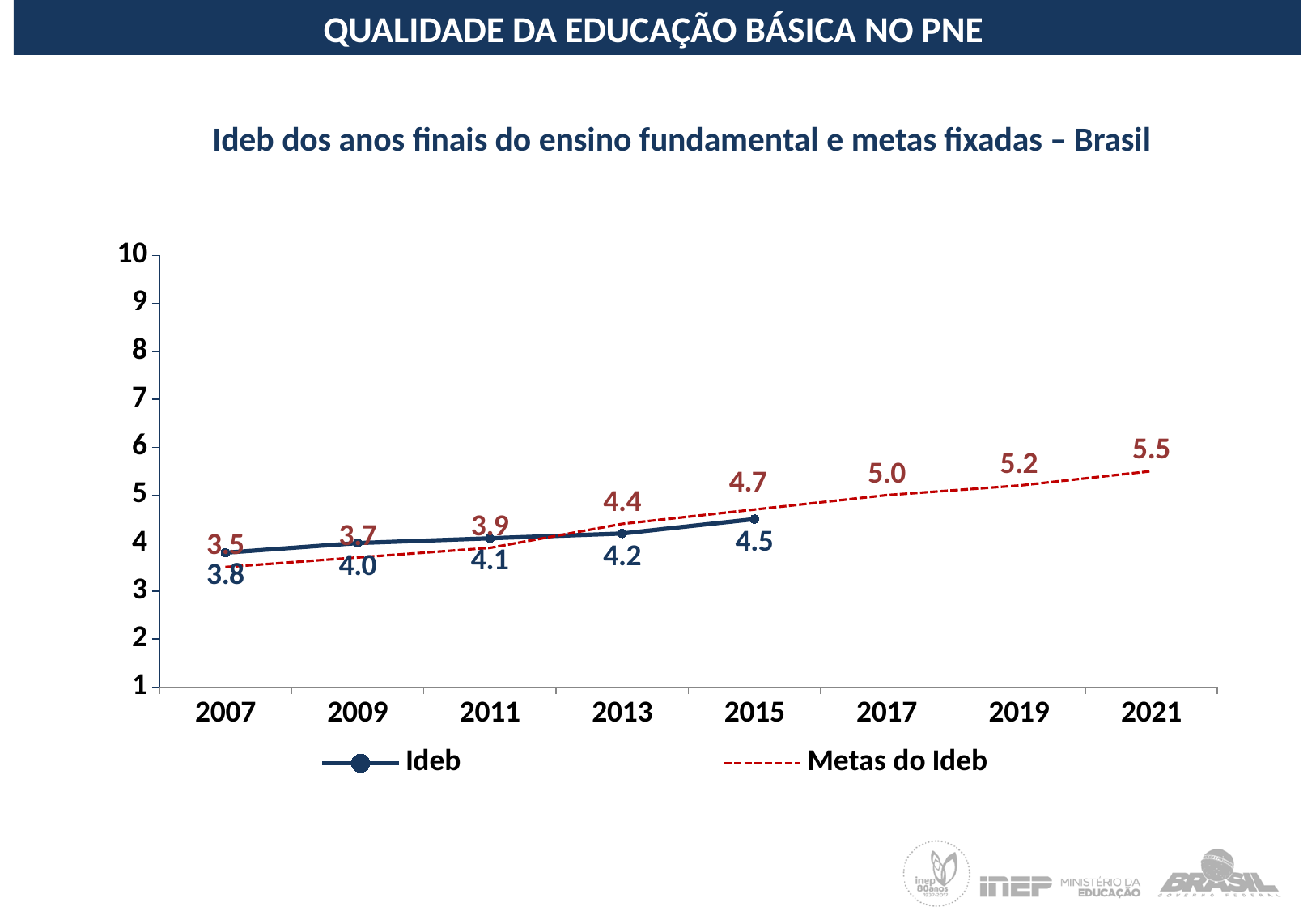
How many series does the legend list? 2 In which year is the Metas do Ideb value highest? 2021 What is the Metas do Ideb value for 2013? 4.4 What is the Metas do Ideb value for 2021? 5.5 Do the Ideb values rise or fall from 2007 to 2015? Rise What is the Ideb value for 2015? 4.5 What is the Ideb value for 2007? 3.8 What kind of chart is this? Line chart In which year is the Ideb value lowest? 2007 What is the difference between the Metas do Ideb value and the Ideb value in 2015? 0.2 How many years are shown on the x axis? 8 In 2013, which is larger: the Ideb value or the Metas do Ideb value? Metas do Ideb